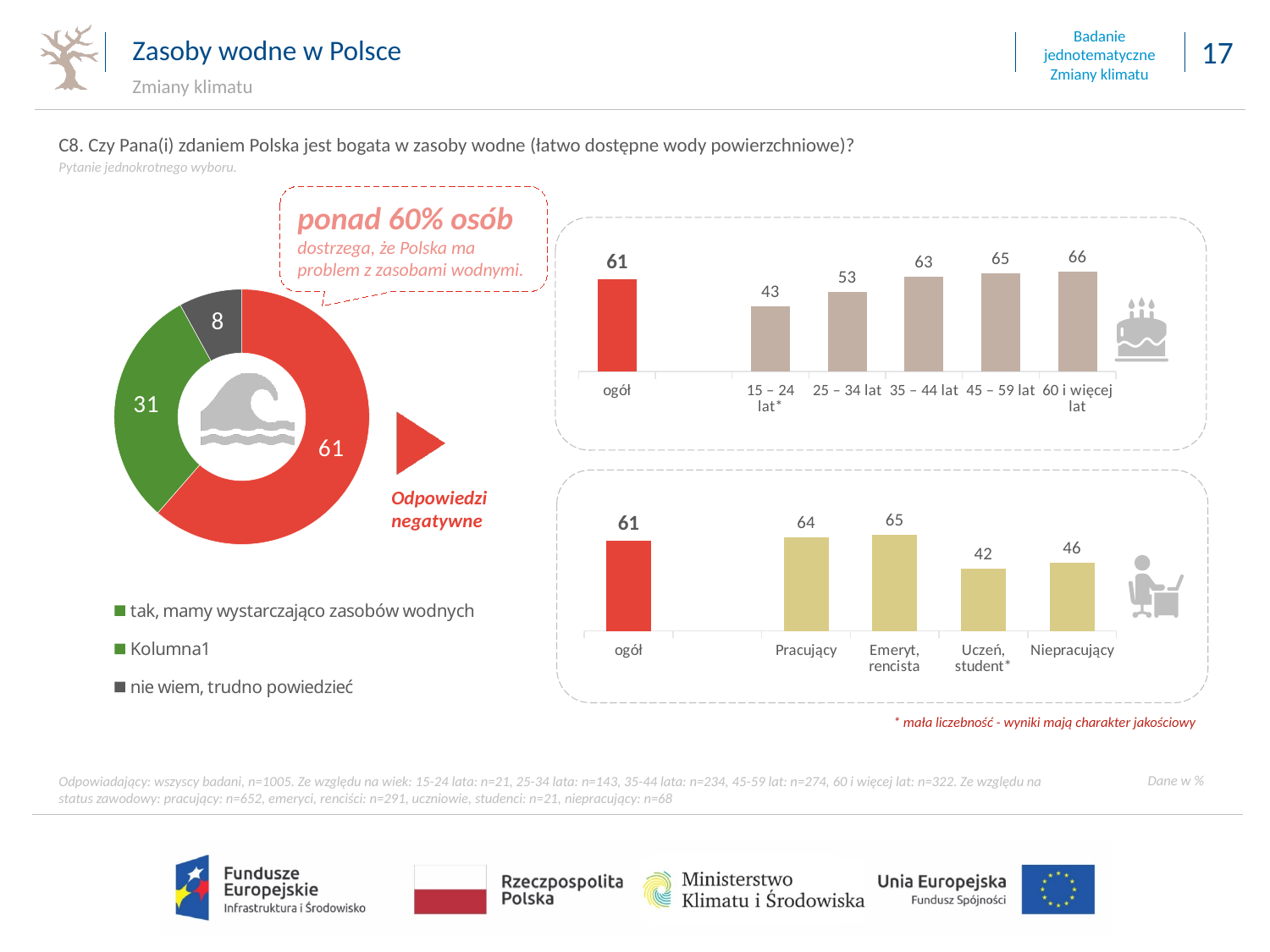
In the age-group bar chart on the top right, which age group has the lowest value? 15 – 24 lat* In the age-group bar chart on the top right, do the values rise or fall from 15 – 24 lat* to 60 i więcej lat? rise In the employment-status bar chart on the bottom right, which category has the lowest value? Uczeń, student* What kind of chart is shown on the left of the slide? donut (pie) chart In the age-group bar chart on the top right, what is the difference between the values for 60 i więcej lat and 15 – 24 lat*? 23 In the employment-status bar chart on the bottom right, what is the difference between the values for Pracujący and Uczeń, student*? 22 In the employment-status bar chart on the bottom right, how many categories are shown on the x axis? 5 In the employment-status bar chart on the bottom right, what is the value for Emeryt, rencista? 65 In the donut chart on the left, what is the value of the red slice labelled 'Odpowiedzi negatywne'? 61 In the age-group bar chart on the top right, what is the value for 15 – 24 lat*? 43 In the employment-status bar chart on the bottom right, which is larger, the value for Pracujący or the value for Niepracujący? Pracujący In the age-group bar chart on the top right, which age group has the highest value? 60 i więcej lat